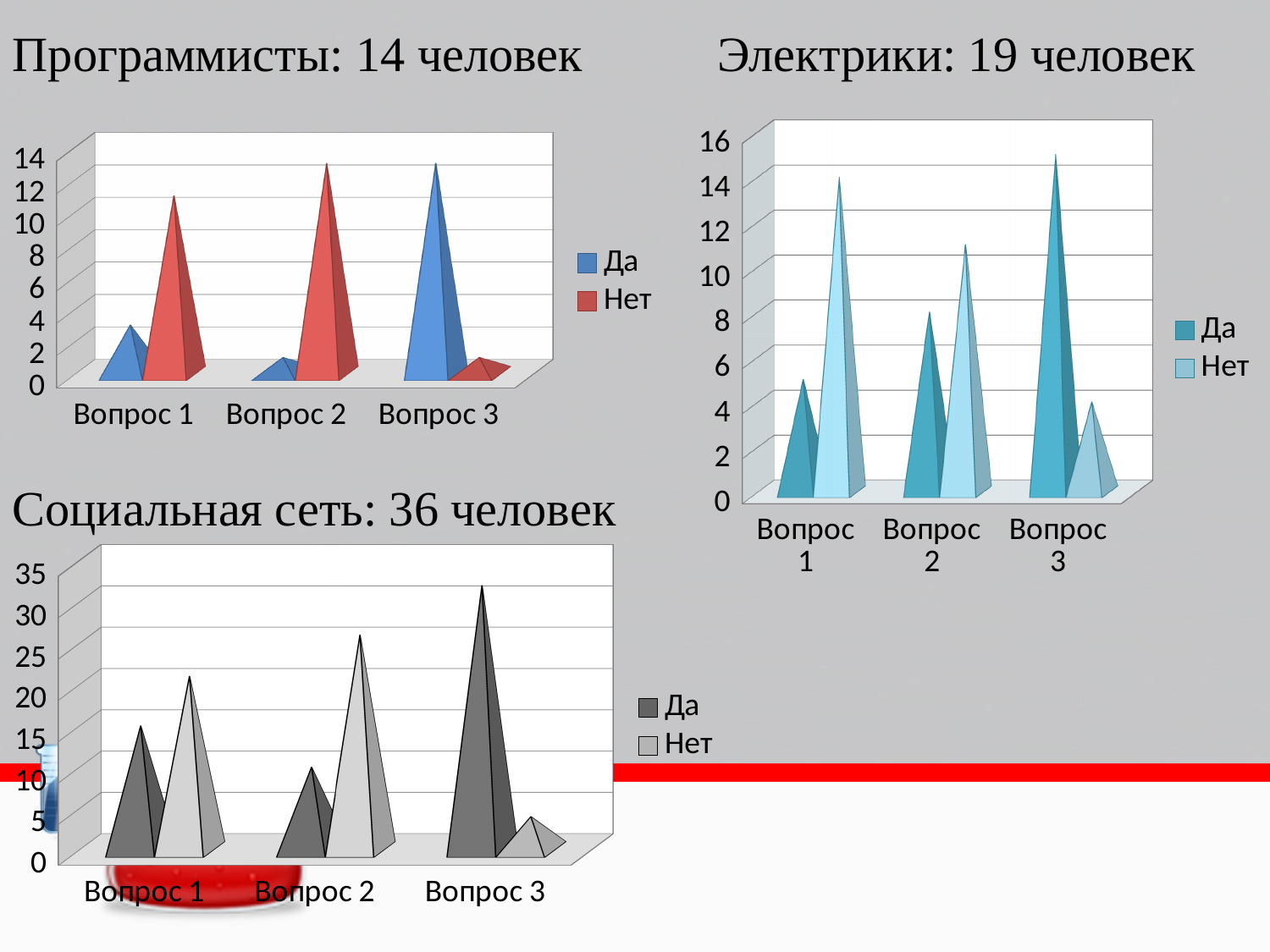
How many series does the legend of the chart titled 'Электрики: 19 человек' list? 2 In the chart titled 'Электрики: 19 человек', which question has the highest 'Да' value? Вопрос 3 In the chart titled 'Программисты: 14 человек', is the value for 'Нет' at Вопрос 2 greater or less than 10? greater In the chart titled 'Социальная сеть: 36 человек', is the value for 'Нет' at Вопрос 2 greater or less than 20? greater In the chart titled 'Социальная сеть: 36 человек', is the value for 'Да' at Вопрос 3 greater or less than 30? greater What kind of chart is the one titled 'Социальная сеть: 36 человек'? bar chart In the chart titled 'Программисты: 14 человек', which is larger at Вопрос 3, 'Да' or 'Нет'? Да In the chart titled 'Социальная сеть: 36 человек', which question has the lowest 'Нет' value? Вопрос 3 How many categories are shown on the x axis of the chart titled 'Программисты: 14 человек'? 3 In the chart titled 'Электрики: 19 человек', which is larger at Вопрос 2, 'Да' or 'Нет'? Нет